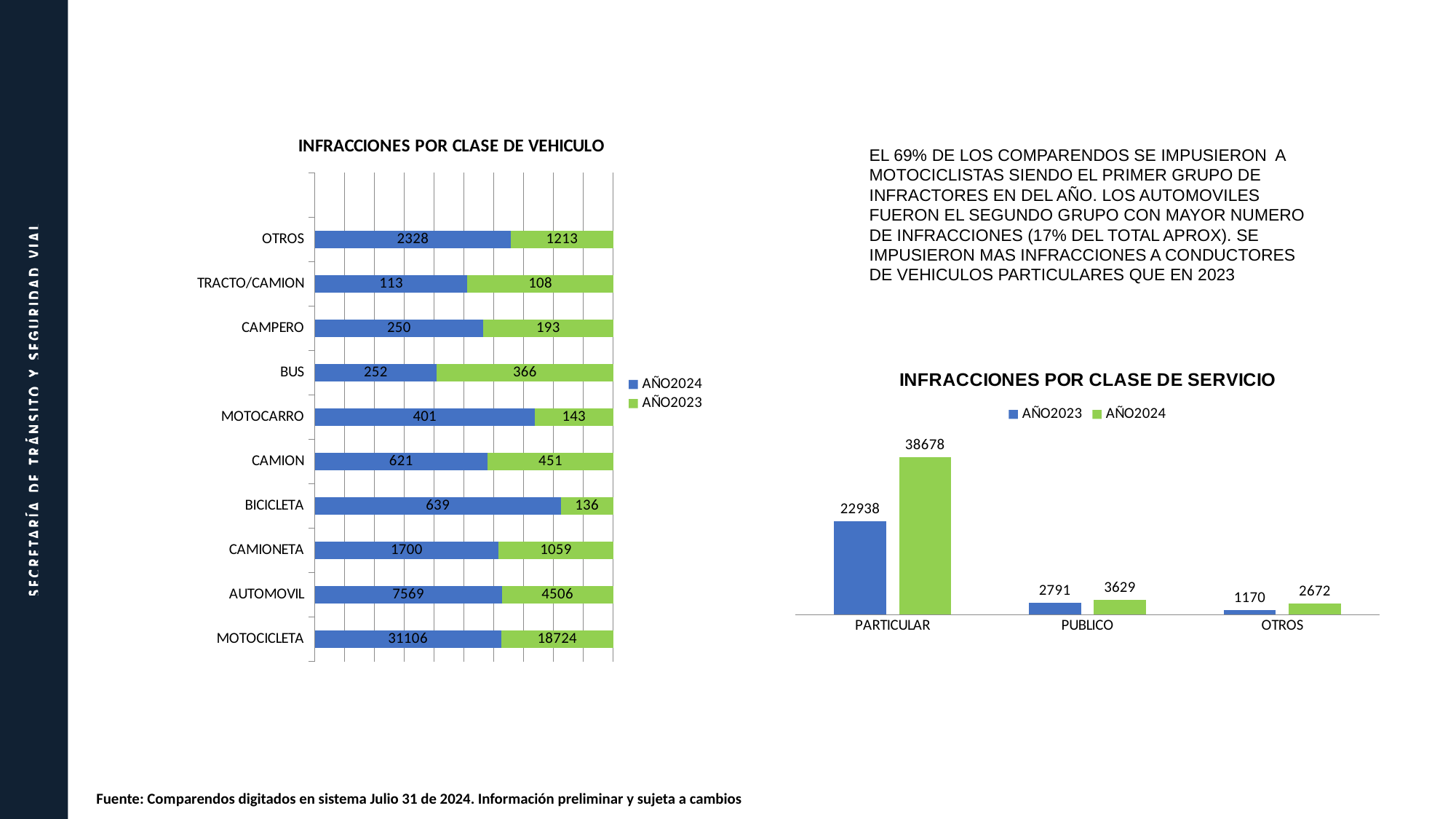
In the chart 'INFRACCIONES POR CLASE DE VEHICULO', which vehicle class has the lowest AÑO2023 value? TRACTO/CAMION How many vehicle classes are shown in the chart 'INFRACCIONES POR CLASE DE VEHICULO'? 10 In the chart 'INFRACCIONES POR CLASE DE VEHICULO', what is the value for MOTOCICLETA in AÑO2024? 31106 In the chart 'INFRACCIONES POR CLASE DE VEHICULO', which vehicle class has the highest AÑO2024 value? MOTOCICLETA In the chart 'INFRACCIONES POR CLASE DE VEHICULO', which is larger for BUS: the AÑO2024 value or the AÑO2023 value? AÑO2023 In the chart 'INFRACCIONES POR CLASE DE SERVICIO', what is the difference between the AÑO2024 and AÑO2023 values for PUBLICO? 838 In the chart 'INFRACCIONES POR CLASE DE VEHICULO', what is the value for AUTOMOVIL in AÑO2023? 4506 In the chart 'INFRACCIONES POR CLASE DE SERVICIO', what is the value for OTROS in AÑO2023? 1170 How many series does the legend list in the chart 'INFRACCIONES POR CLASE DE SERVICIO'? 2 In the chart 'INFRACCIONES POR CLASE DE SERVICIO', what is the value for PARTICULAR in AÑO2024? 38678 In the chart 'INFRACCIONES POR CLASE DE VEHICULO', what is the difference between the AÑO2024 and AÑO2023 values for CAMIONETA? 641 What kind of chart is 'INFRACCIONES POR CLASE DE SERVICIO'? Bar chart